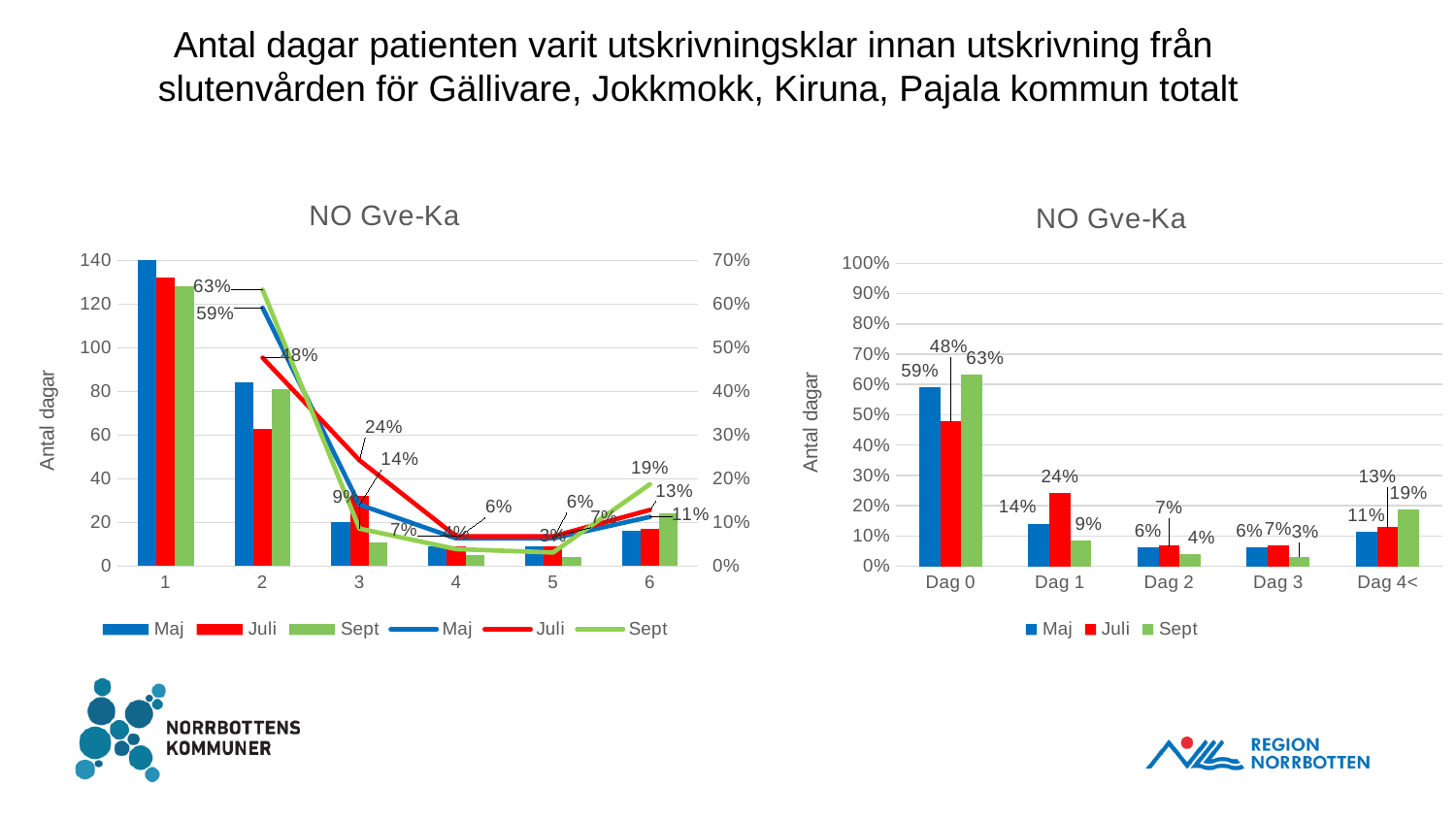
On the right chart, what is the value for Maj at Dag 0? 59% On the left chart, is the Juli bar for category 2 greater or less than 80? less On the right chart, what is the value for Juli at Dag 1? 24% On the left chart, is the Maj bar for category 3 greater or less than 40? less On the right chart, how many categories are shown on the x axis? 5 On the right chart, which category has the lowest value for Sept? Dag 3 On the right chart, which category has the highest value for Sept? Dag 0 On the right chart, how many series does the legend list? 3 On the right chart, what is the value for Sept at Dag 4<? 19% What is the title of the right chart? NO Gve-Ka On the right chart, which is larger at Dag 1: Maj or Sept? Maj On the right chart, what is the difference between Sept and Juli at Dag 0? 15%